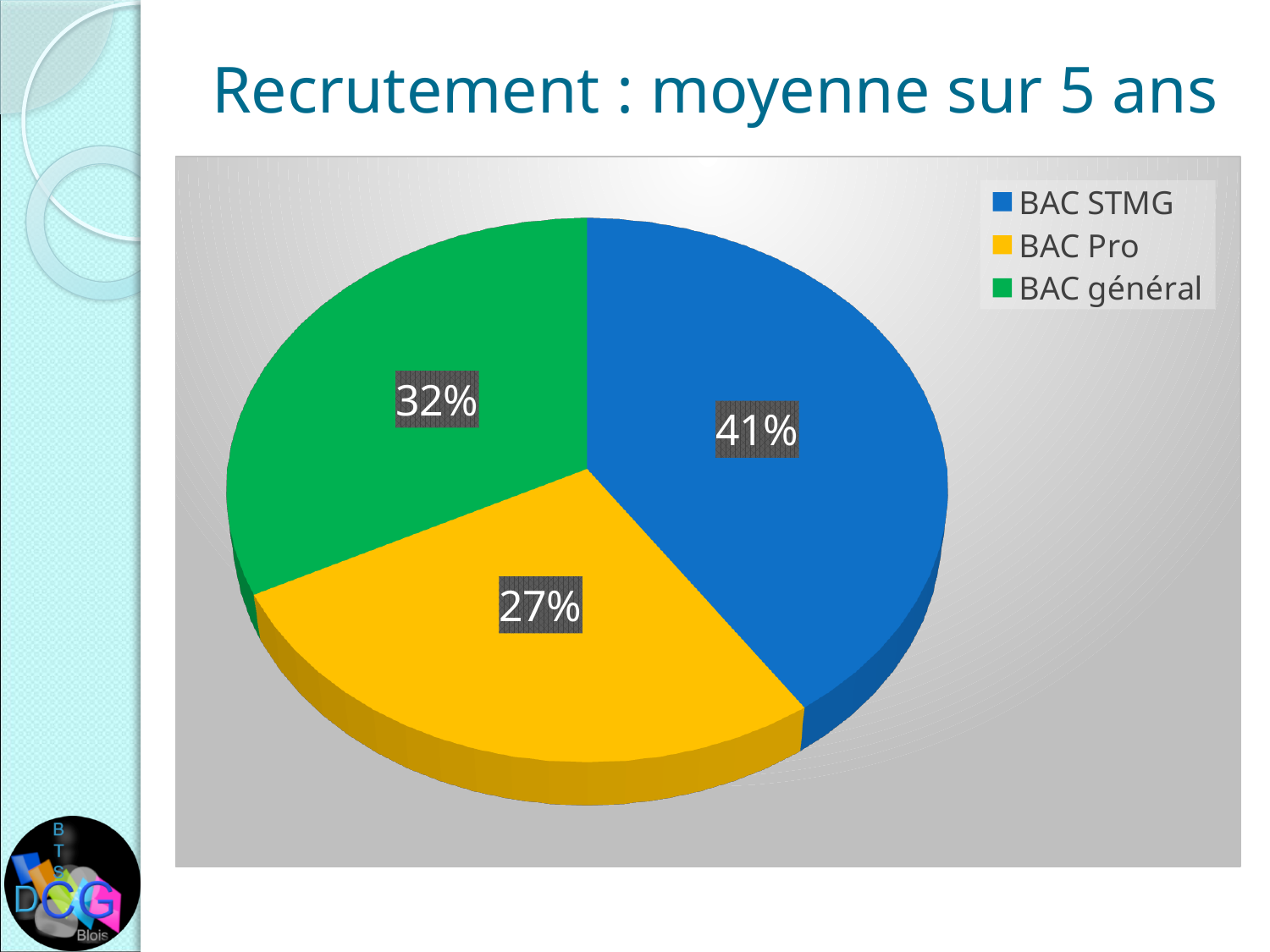
What share of the pie does BAC STMG represent? 41% Which colour represents BAC Pro in the legend? Yellow What share of the pie does BAC général represent? 32% What is the title of the slide containing the chart? Recrutement : moyenne sur 5 ans What kind of chart is shown on the slide? Pie chart Which is larger, the share for BAC général or the share for BAC Pro? BAC général What is the difference in percentage points between BAC STMG and BAC Pro? 14 What share of the pie does BAC Pro represent? 27% What is the difference in percentage points between BAC général and BAC Pro? 5 Which category has the largest slice of the pie? BAC STMG How many categories are shown in the pie chart? 3 Which category has the smallest slice of the pie? BAC Pro